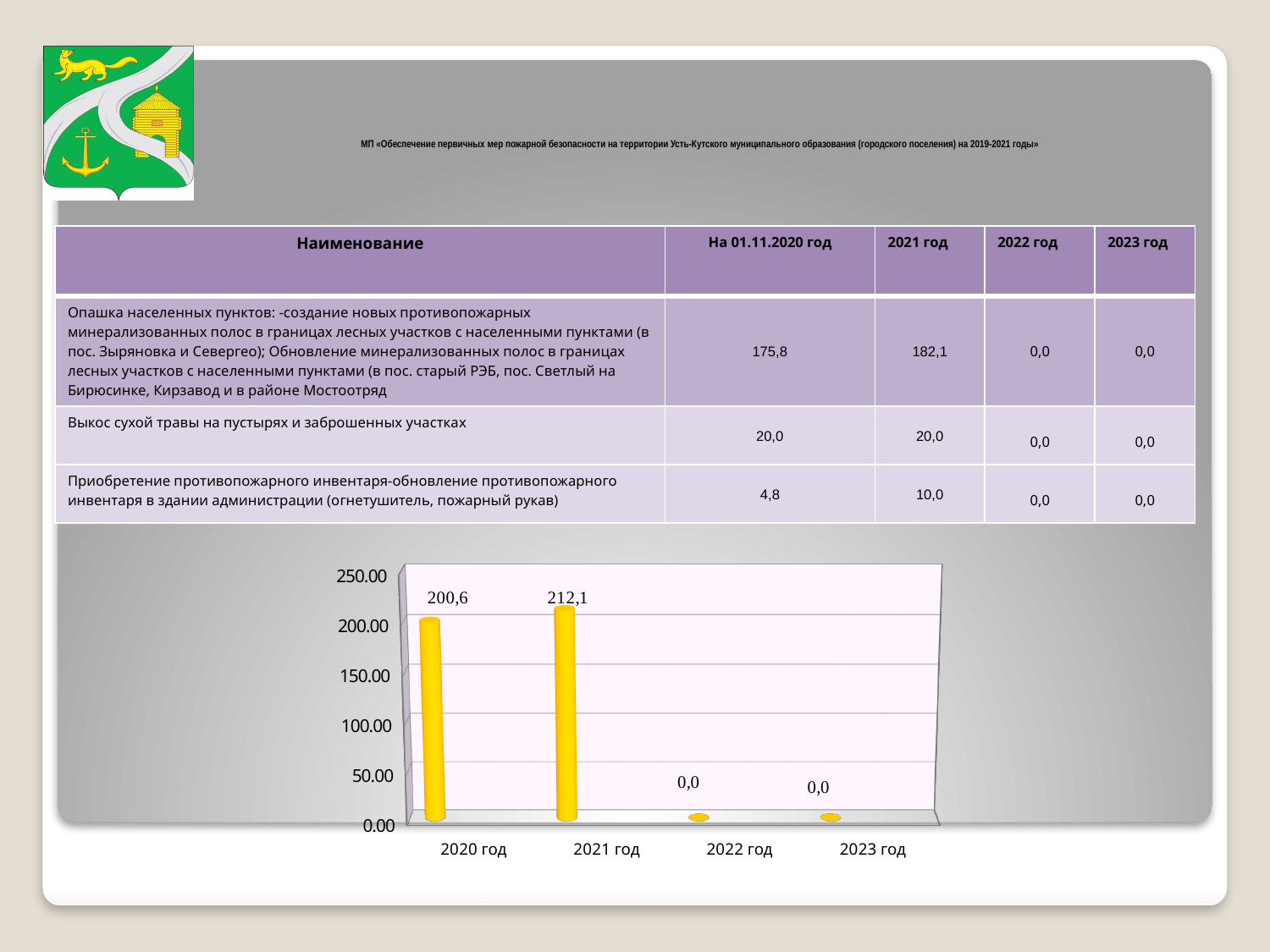
What is the value for 2023 год in the bar chart? 0,0 Is the value for 2021 год in the bar chart greater or less than 250.00? less What is the highest tick value shown on the y axis of the bar chart? 250.00 Which is larger in the bar chart, the value for 2020 год or the value for 2021 год? 2021 год What is the difference between the values for 2021 год and 2020 год in the bar chart? 11,5 Is the value for 2020 год in the bar chart greater or less than 150.00? greater What is the value for 2021 год in the bar chart? 212,1 What kind of chart is shown on the slide? bar chart What is the value for 2020 год in the bar chart? 200,6 What is the value for 2022 год in the bar chart? 0,0 How many categories are shown on the x axis of the bar chart? 4 Which category has the highest value in the bar chart? 2021 год